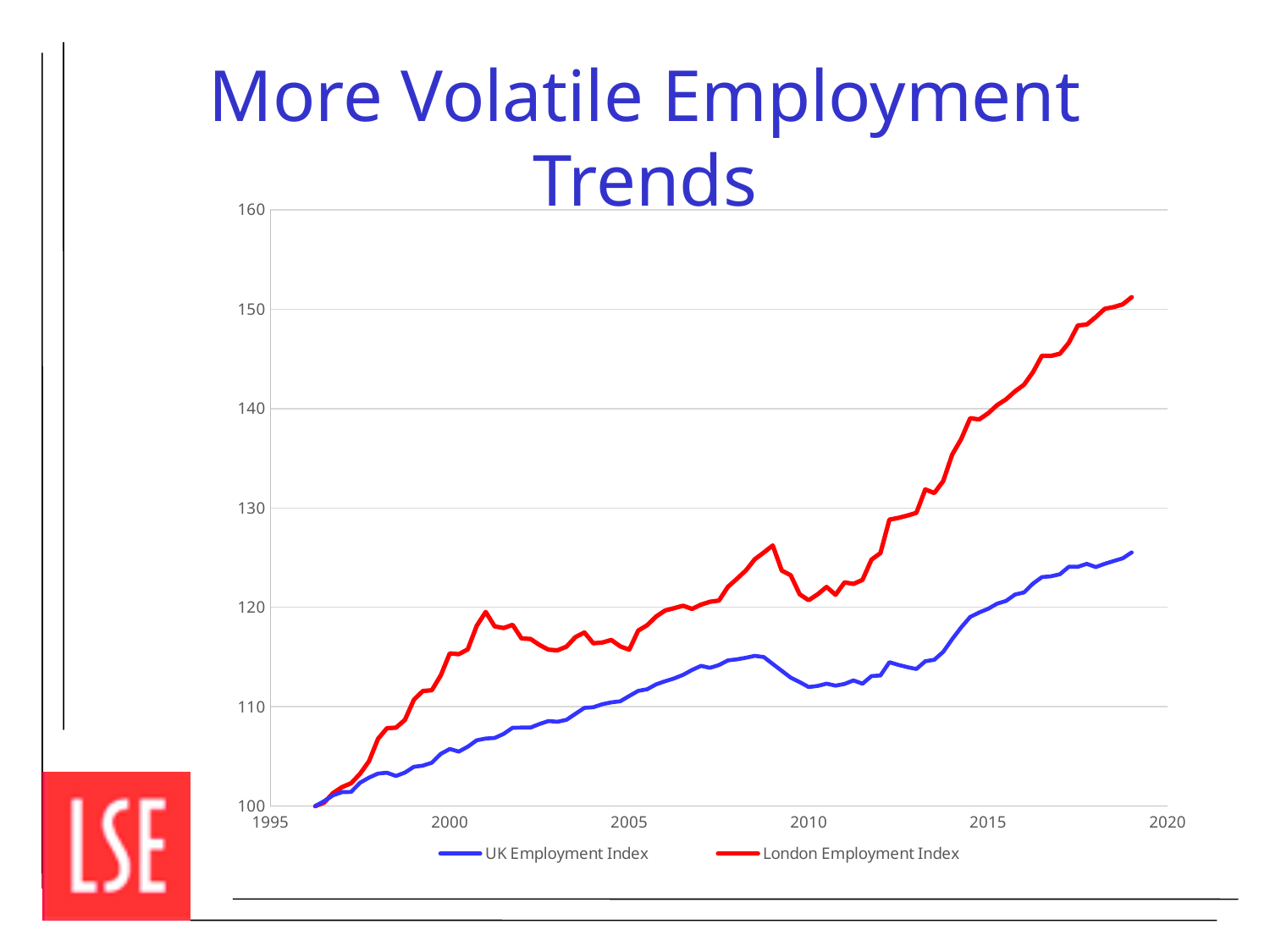
Which colour is used for the London Employment Index line? red Is the value of the London Employment Index in 2019 greater or less than 150? greater Is the value of the London Employment Index in 2000 greater or less than 110? greater Is the value of the UK Employment Index in 2000 greater or less than 110? less What is the title of the slide's chart? More Volatile Employment Trends Overall, does the London Employment Index rise or fall from 1996 to 2019? rise What kind of chart is shown on the slide? line chart Which series is higher in 2019, the UK Employment Index or the London Employment Index? London Employment Index Overall, does the UK Employment Index rise or fall from 1996 to 2019? rise How many series does the legend list? 2